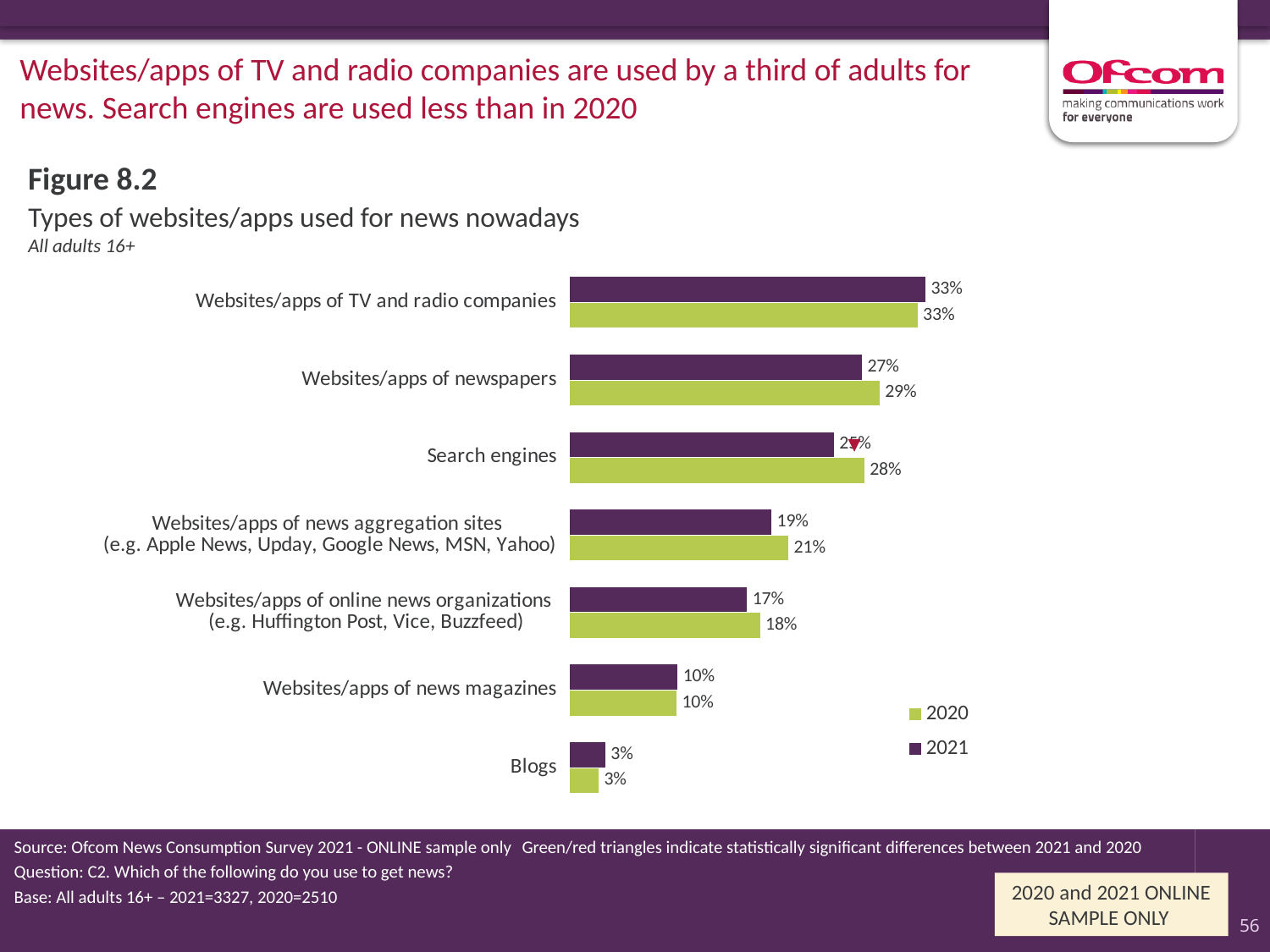
Which category has the highest 2021 value? Websites/apps of TV and radio companies What is the difference between the 2020 and 2021 values for Websites/apps of newspapers? 2% How many categories of websites/apps are shown in the chart? 7 What is the 2020 value for Search engines? 28% Which category has the lowest 2020 value? Blogs What is the 2021 value for Websites/apps of news aggregation sites? 19% Which is larger for Websites/apps of online news organizations: the 2020 value or the 2021 value? 2020 What is the 2021 value for Websites/apps of TV and radio companies? 33% What is the 2020 value for Websites/apps of newspapers? 29% Which colour represents the 2020 series in the chart? green How many series does the legend list? 2 What kind of chart is shown on the slide? bar chart